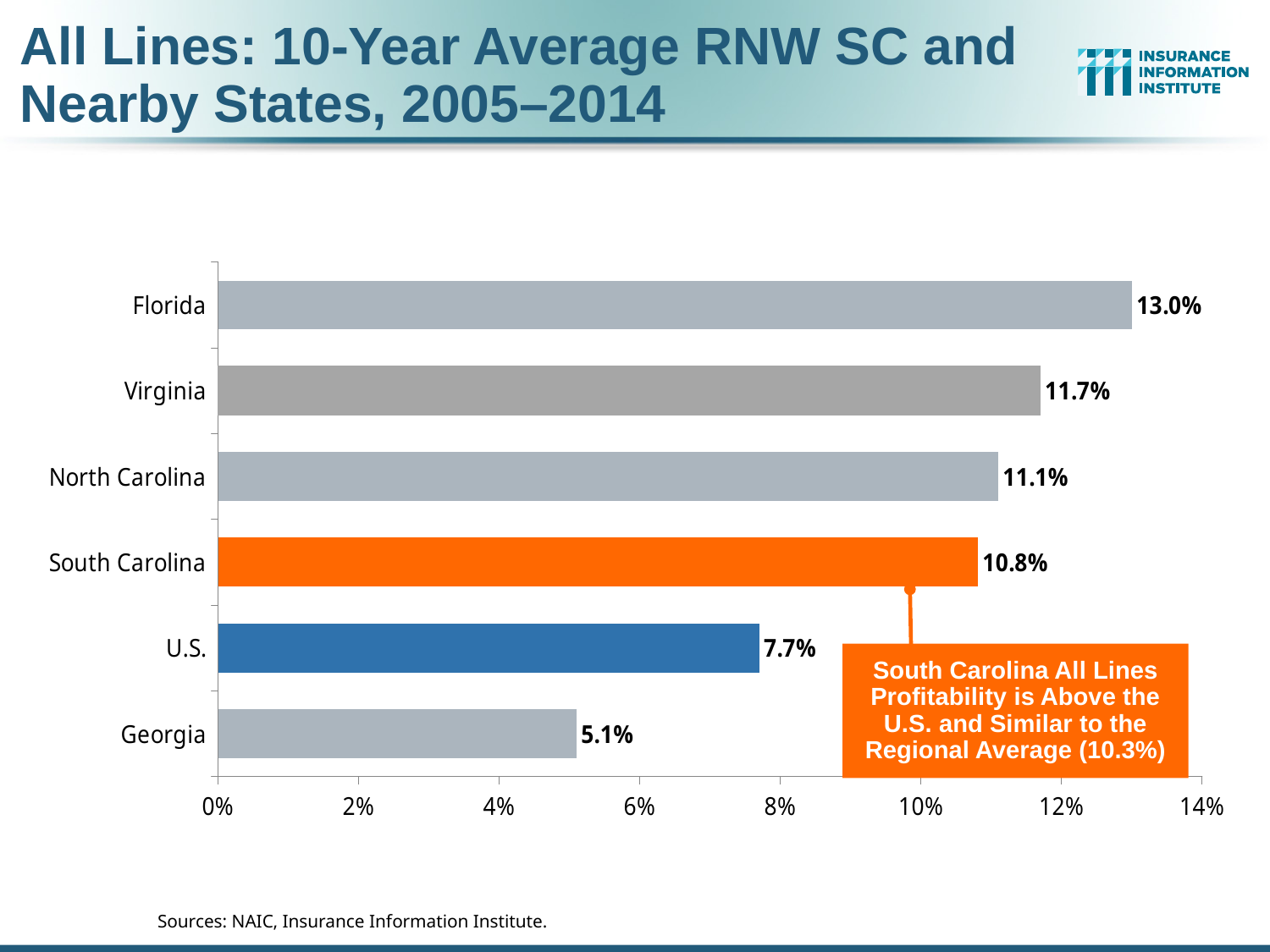
What is the 10-year average RNW for South Carolina? 10.8% Is the value for Georgia greater or less than 6%? less Which category has the highest value? Florida What kind of chart is shown on the slide? Bar chart What is the difference between the values for Florida and Georgia? 7.9% Which bar is coloured orange? South Carolina Which category has the lowest value? Georgia How much higher is South Carolina's value than the U.S. value? 3.1% What is the value shown for Florida? 13.0% What is the value shown for the U.S.? 7.7% How many categories are shown in the chart? 6 Which has a larger value, Virginia or North Carolina? Virginia